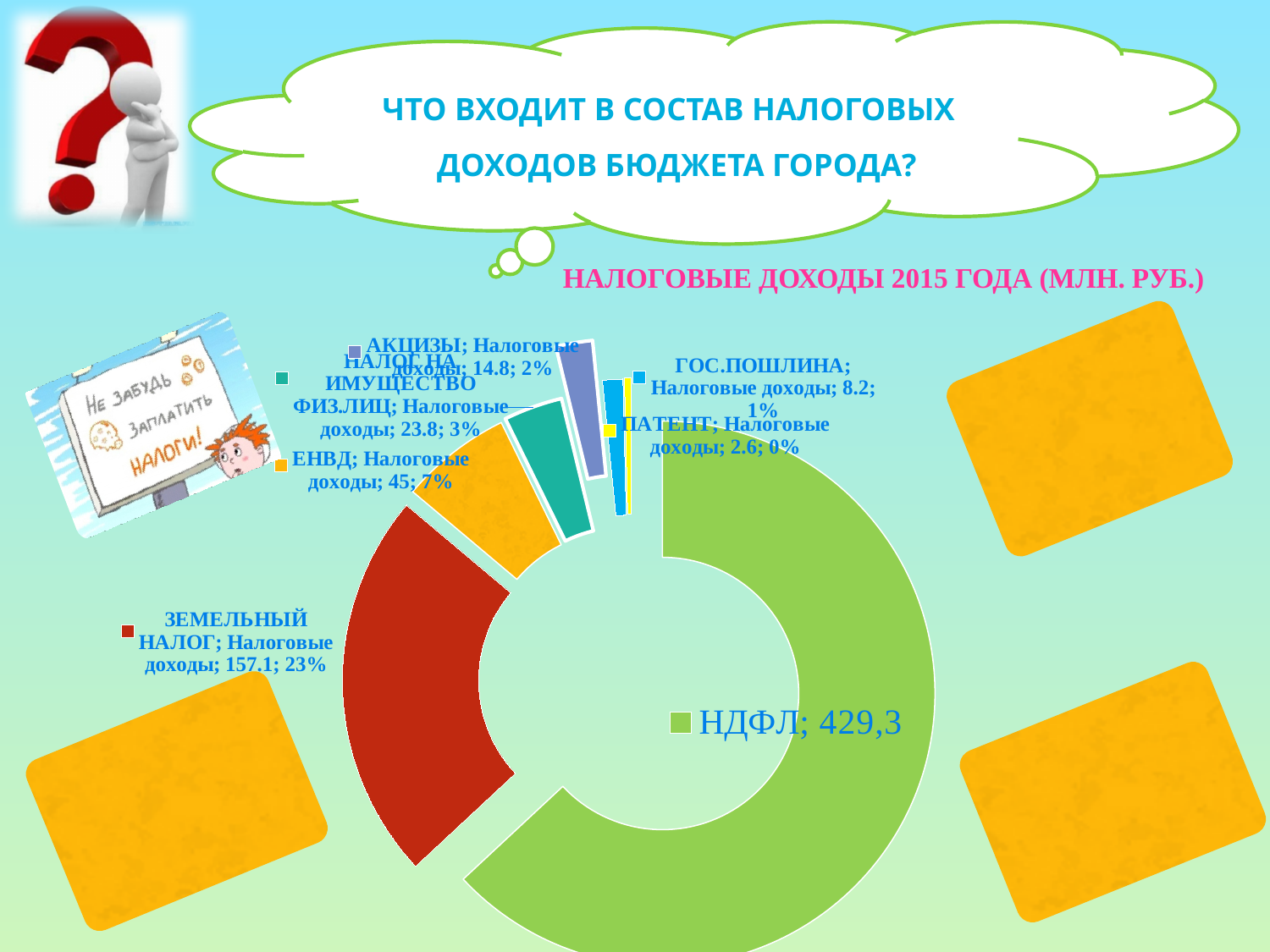
What is the value for ЗЕМЕЛЬНЫЙ НАЛОГ in the chart? 157.1 What share of the total does ЗЕМЕЛЬНЫЙ НАЛОГ represent according to its label? 23% What is the difference between the values for ЗЕМЕЛЬНЫЙ НАЛОГ and ЕНВД? 112.1 What is the value for НДФЛ in the chart? 429,3 How many categories are shown in the chart? 7 Which is larger, the value for ГОС.ПОШЛИНА or the value for АКЦИЗЫ? АКЦИЗЫ Which category has the smallest value in the chart? ПАТЕНТ What is the title of the chart? НАЛОГОВЫЕ ДОХОДЫ 2015 ГОДА (МЛН. РУБ.) What is the value for АКЦИЗЫ in the chart? 14.8 Which category has the largest value in the chart? НДФЛ What is the value for ПАТЕНТ in the chart? 2.6 What is the value for ЕНВД in the chart? 45